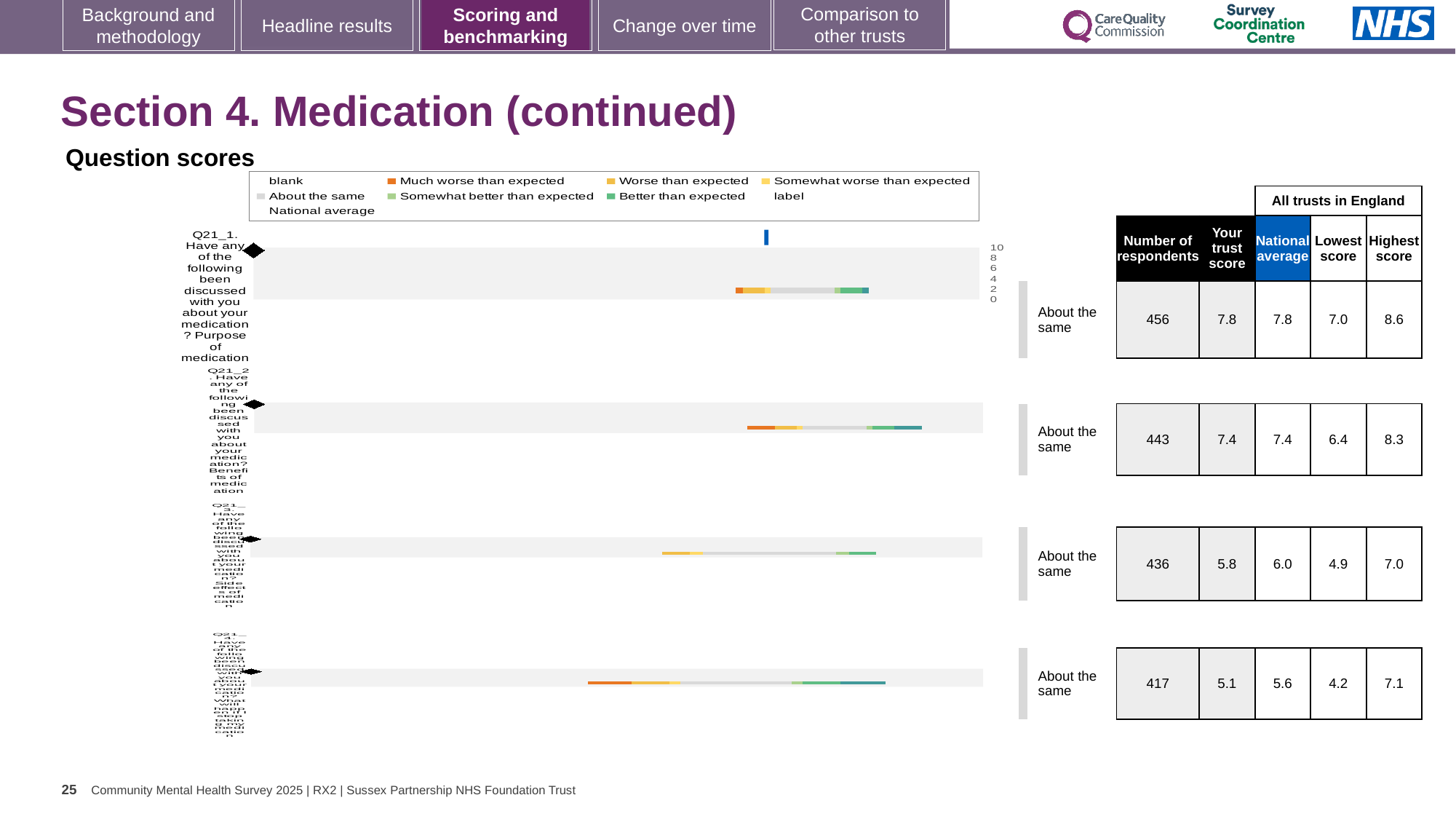
In the table beside the chart, what is the number of respondents for the first question (Q21_1, purpose of medication)? 456 What colour does the legend use for 'Much worse than expected'? orange What benchmark category is shown next to each of the four question bars? About the same Which of the four questions has the highest 'Your trust score' in the table? Q21_1 (first row), 7.8 In the table beside the chart, what is the national average for the fourth (bottom) question? 5.6 For the first question (Q21_1), what is the difference between the highest score and the lowest score in the table? 1.6 For the fourth (bottom) question, which is larger: 'Your trust score' or the national average? national average Which of the four questions has the lowest number of respondents in the table? the fourth (bottom) question, 417 How many question bars are plotted in the chart? 4 What kind of chart is shown under 'Question scores'? bar chart In the table beside the chart, what is 'Your trust score' for the first question (Q21_1)? 7.8 How many entries does the chart legend list? 9